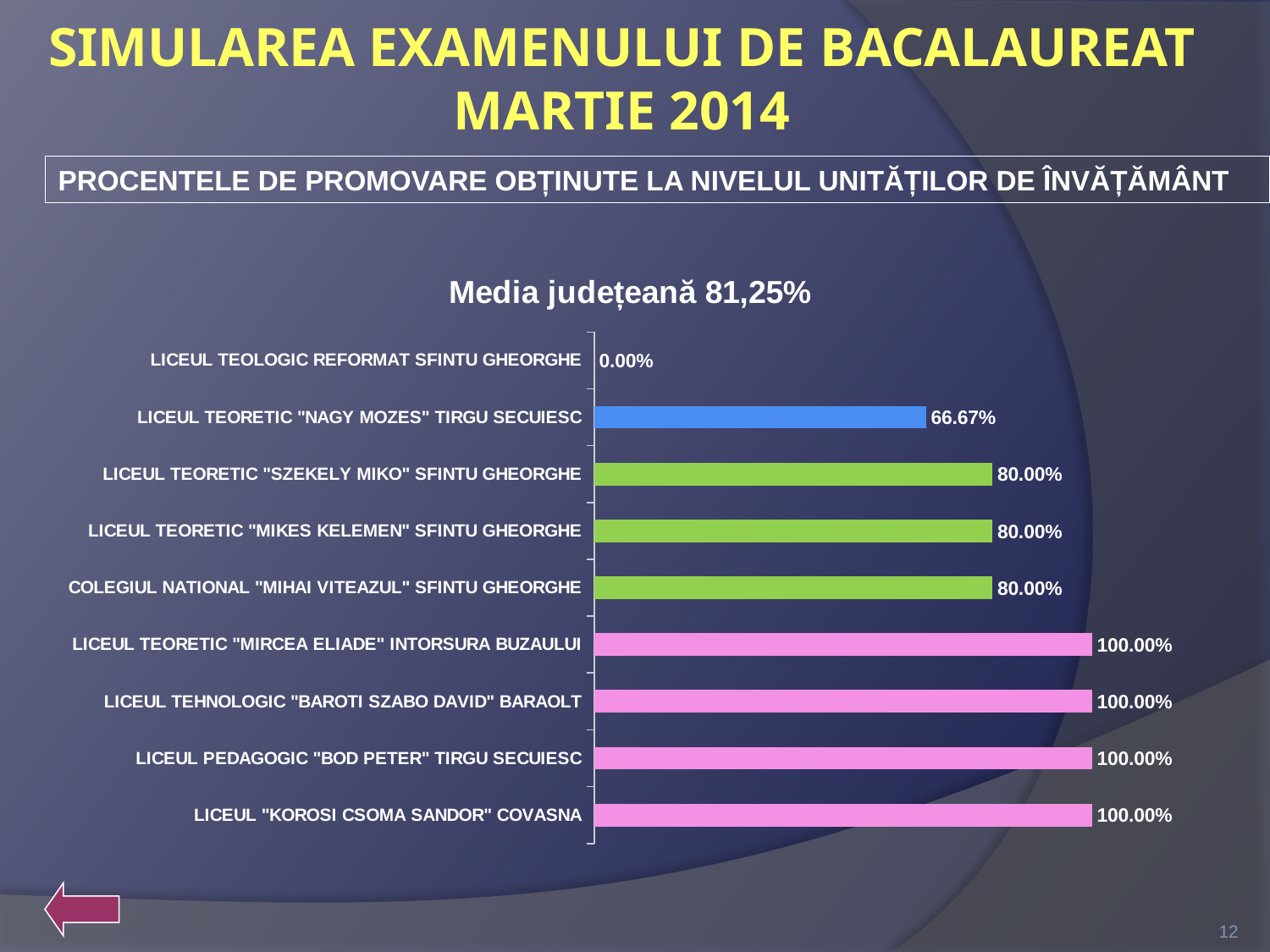
What is the value for LICEUL TEOLOGIC REFORMAT SFINTU GHEORGHE? 0.00% What is the difference between the values for COLEGIUL NATIONAL "MIHAI VITEAZUL" SFINTU GHEORGHE and LICEUL TEORETIC "NAGY MOZES" TIRGU SECUIESC? 13.33% How many schools are shown in the chart? 9 What is the value for LICEUL TEORETIC "NAGY MOZES" TIRGU SECUIESC? 66.67% What colour are the bars with a value of 100.00%? Pink What is the value for LICEUL "KOROSI CSOMA SANDOR" COVASNA? 100.00% How many schools have a value of 100.00%? 4 Which has the larger value, LICEUL TEORETIC "NAGY MOZES" TIRGU SECUIESC or LICEUL TEORETIC "MIKES KELEMEN" SFINTU GHEORGHE? LICEUL TEORETIC "MIKES KELEMEN" SFINTU GHEORGHE What kind of chart is shown on the slide? Bar chart What is the value for LICEUL TEORETIC "SZEKELY MIKO" SFINTU GHEORGHE? 80.00% What is the title of the chart? Media județeană 81,25% Which school has the lowest value in the chart? LICEUL TEOLOGIC REFORMAT SFINTU GHEORGHE